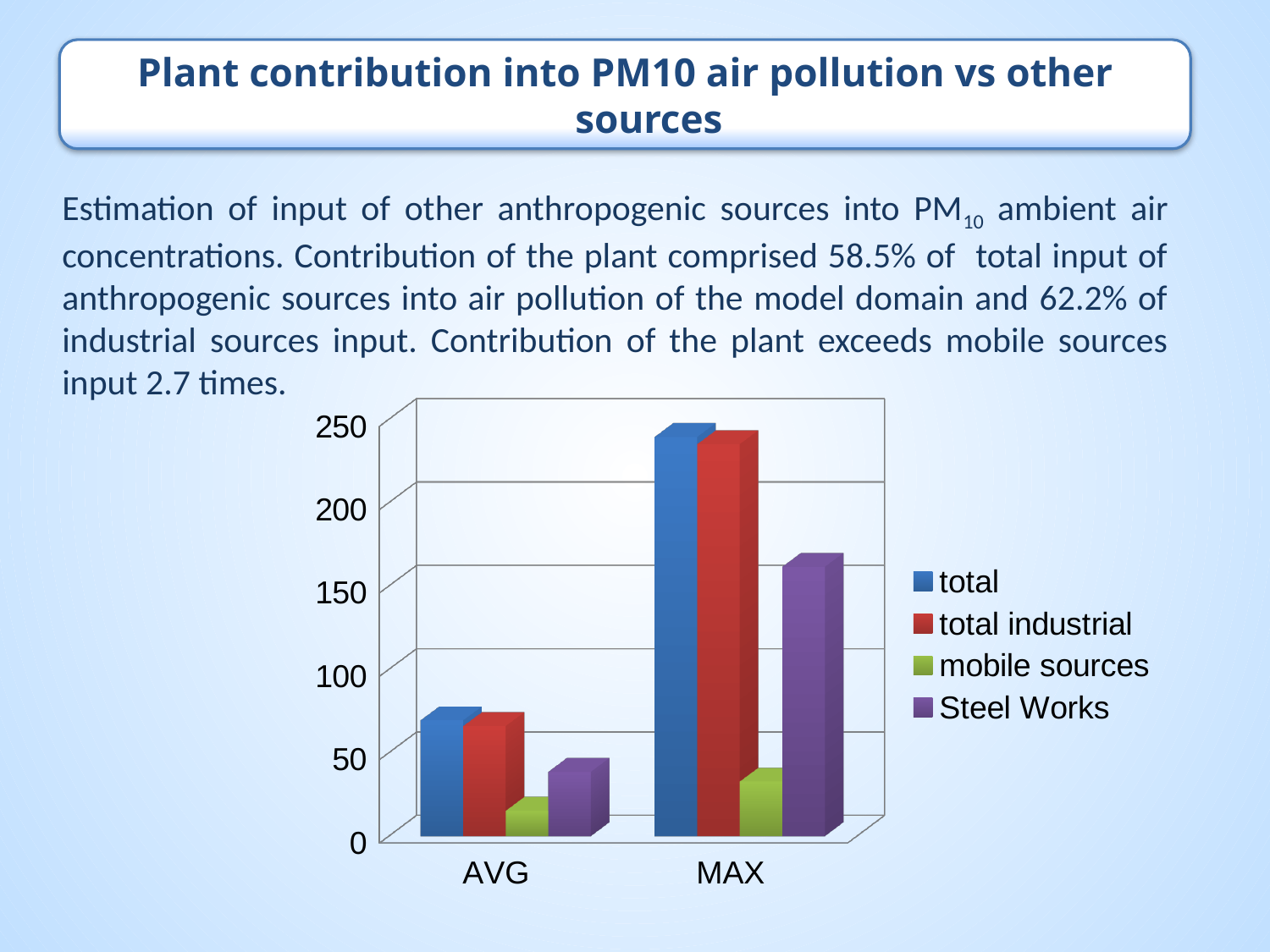
Is the value for total in the AVG category greater or less than 100? less Which series has the lowest value in the AVG category? mobile sources Which series has the lowest value in the MAX category? mobile sources What colour are the bars for the Steel Works series? purple How many categories are shown on the x axis of the chart? 2 Is the value for mobile sources in the MAX category greater or less than 50? less In the MAX category, which is larger: Steel Works or mobile sources? Steel Works What kind of chart is shown on the slide? bar chart Is the value for total in the MAX category greater or less than 200? greater Do the values for the total series rise or fall from AVG to MAX? rise How many series does the chart legend list? 4